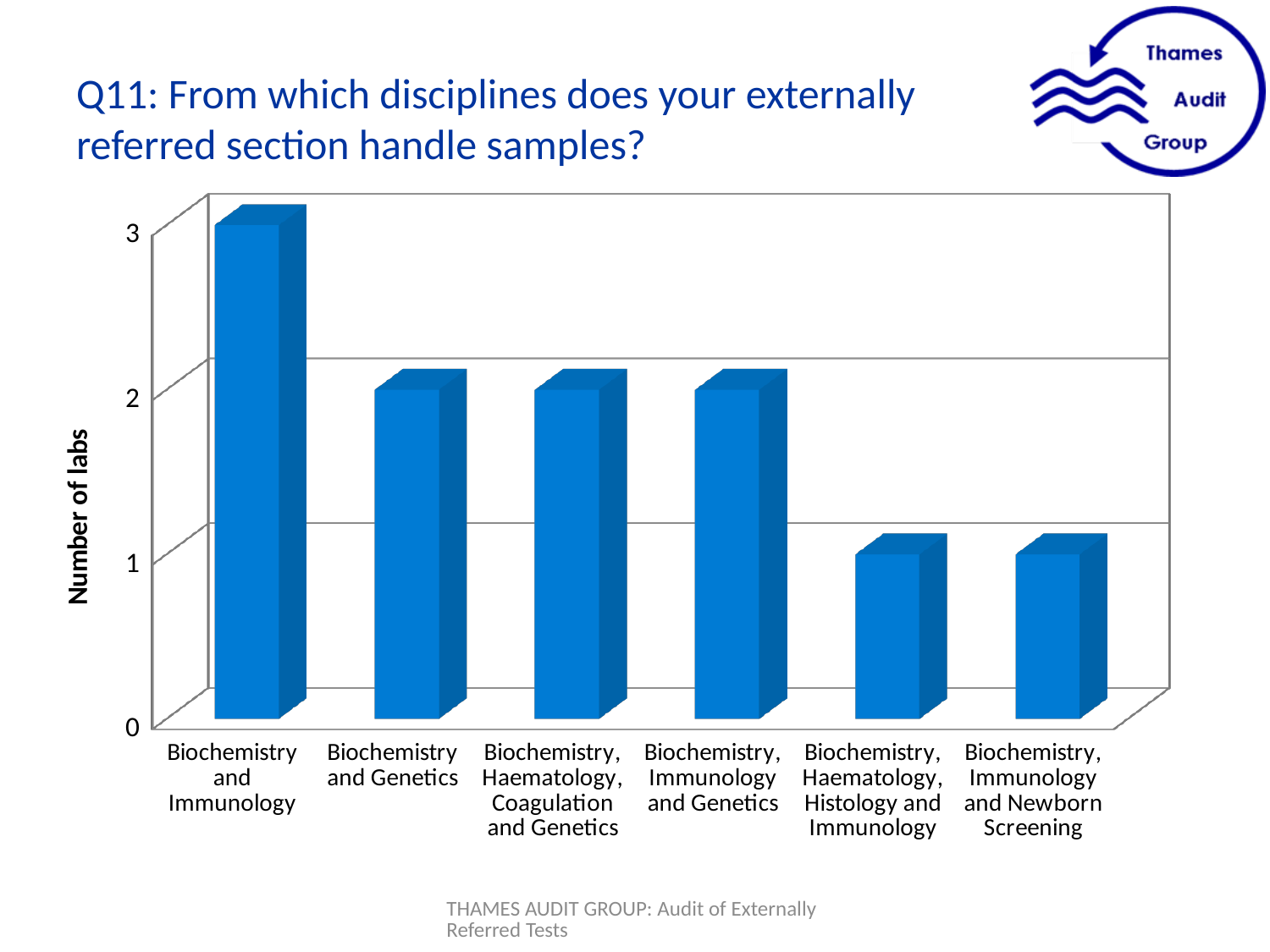
What is the number of labs for Biochemistry, Haematology, Histology and Immunology? 1 Which has more labs: Biochemistry, Haematology, Coagulation and Genetics or Biochemistry, Immunology and Newborn Screening? Biochemistry, Haematology, Coagulation and Genetics Do the bar values generally rise or fall from left to right across the x axis? fall What kind of chart is shown on the slide? bar chart What is the number of labs for Biochemistry and Genetics? 2 Which discipline combination has the highest number of labs? Biochemistry and Immunology What is the difference in number of labs between Biochemistry and Immunology and Biochemistry, Immunology and Genetics? 1 Is the value for Biochemistry and Immunology greater or less than 2? greater What is the label of the vertical axis? Number of labs How many discipline categories are shown on the x axis? 6 What is the number of labs for Biochemistry, Immunology and Newborn Screening? 1 What is the number of labs for Biochemistry and Immunology? 3